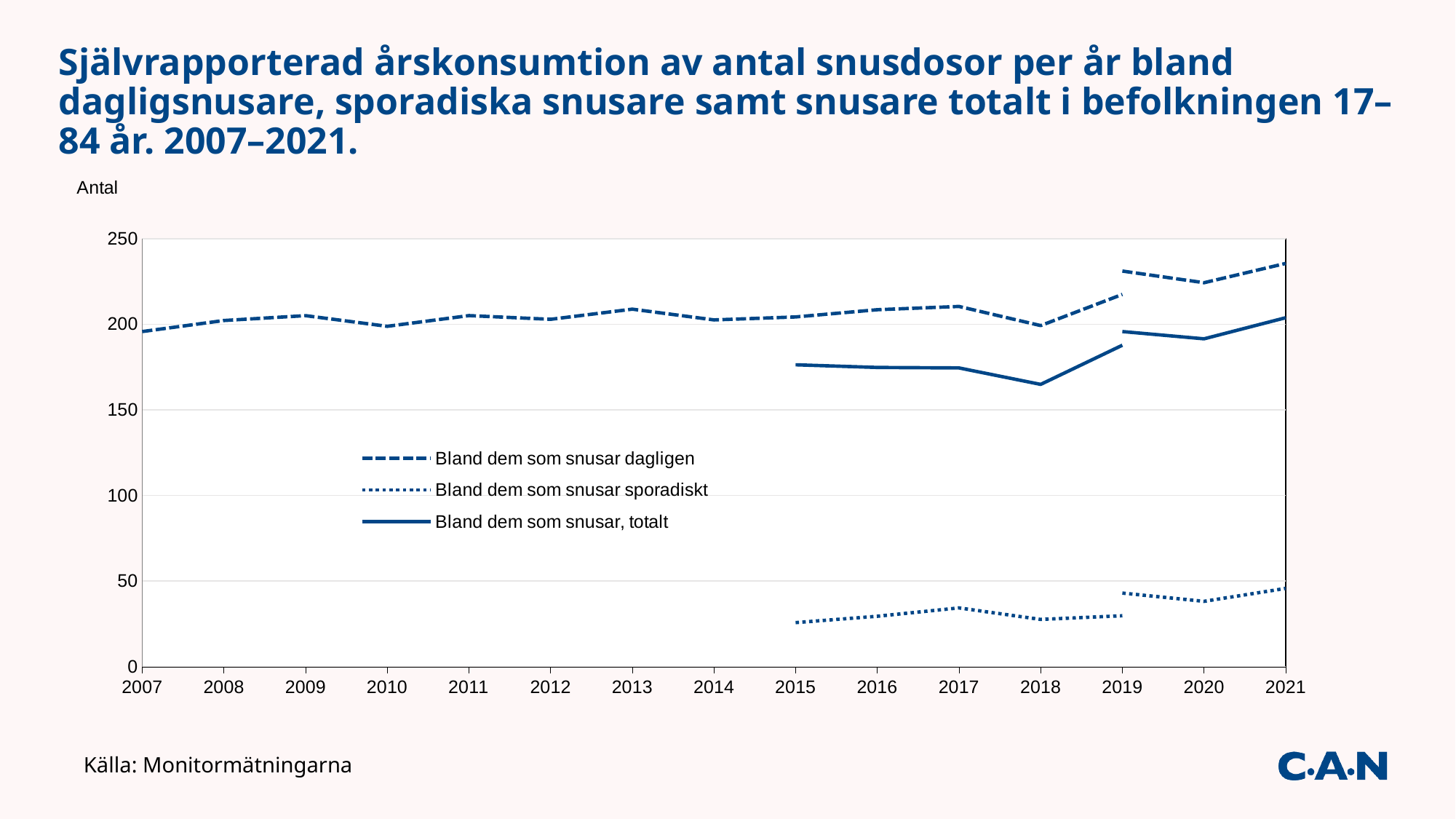
Is the value for 'Bland dem som snusar sporadiskt' in 2015 greater or less than 50? less Is the value for 'Bland dem som snusar, totalt' in 2018 greater or less than 150? greater Does the 'Bland dem som snusar dagligen' line rise or fall from 2019 to 2020? fall Is the value for 'Bland dem som snusar, totalt' in 2015 greater or less than 200? less In which year is the value for 'Bland dem som snusar, totalt' lowest? 2018 For 'Bland dem som snusar, totalt', is the value in 2019 larger or smaller than in 2018? larger How many series does the legend list? 3 What kind of chart is shown on the slide? Line chart How many years are shown on the x axis? 15 In 2021, which series has the larger value: 'Bland dem som snusar dagligen' or 'Bland dem som snusar sporadiskt'? Bland dem som snusar dagligen What is the label on the y axis of the chart? Antal